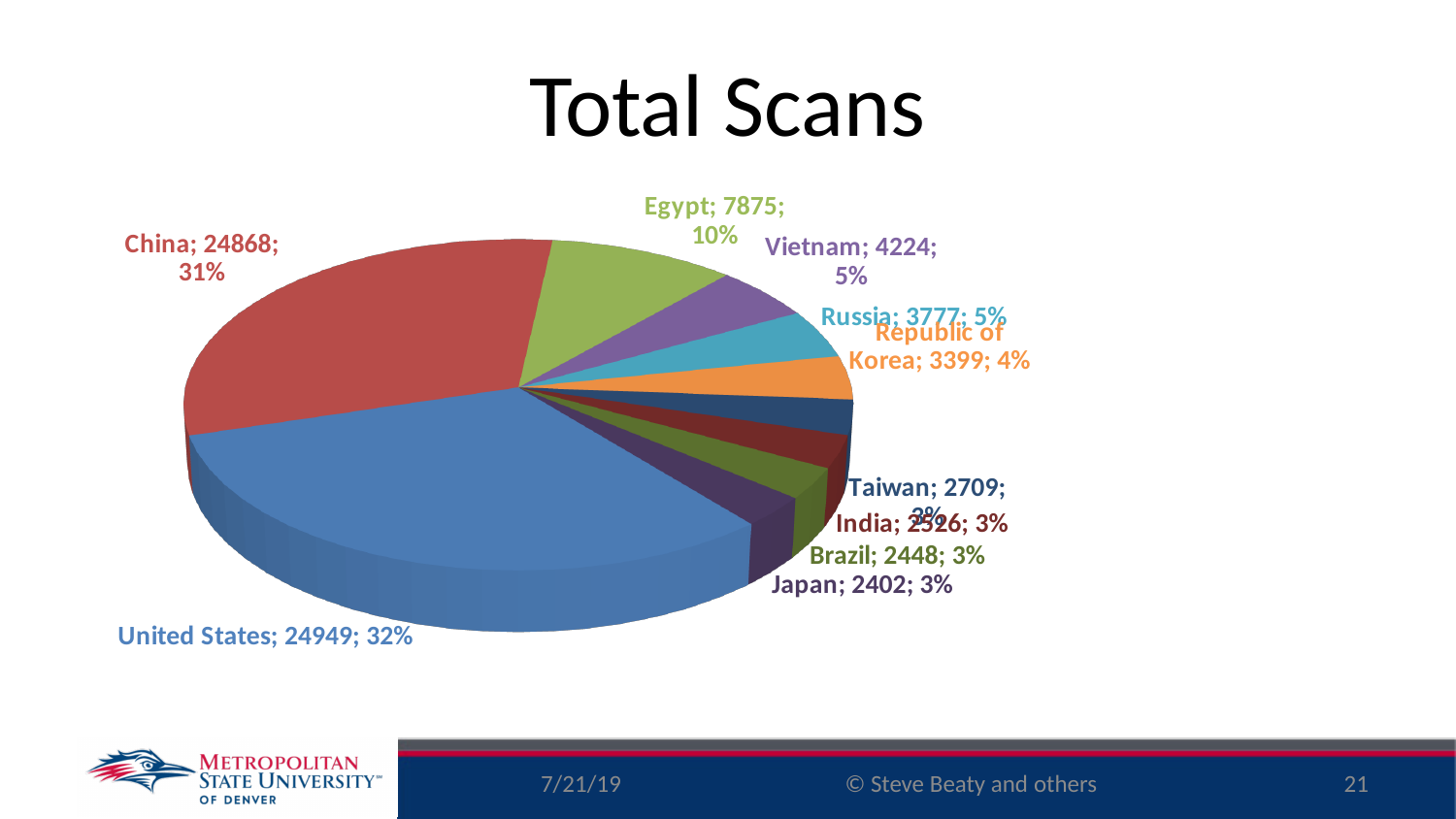
What is the difference in scans between the United States and China? 81 How many countries are labeled in the pie chart? 10 What kind of chart is shown on the slide? pie chart What is the value for Republic of Korea? 3399 What percentage share does Egypt have in the pie chart? 10% Which has more scans, Russia or Vietnam? Vietnam What is the title of the chart? Total Scans How many scans are shown for Vietnam? 4224 What percentage share does the United States have? 32% Which country has the smallest slice of the pie? Japan How many scans are shown for China? 24868 Which country has the largest slice of the pie? United States